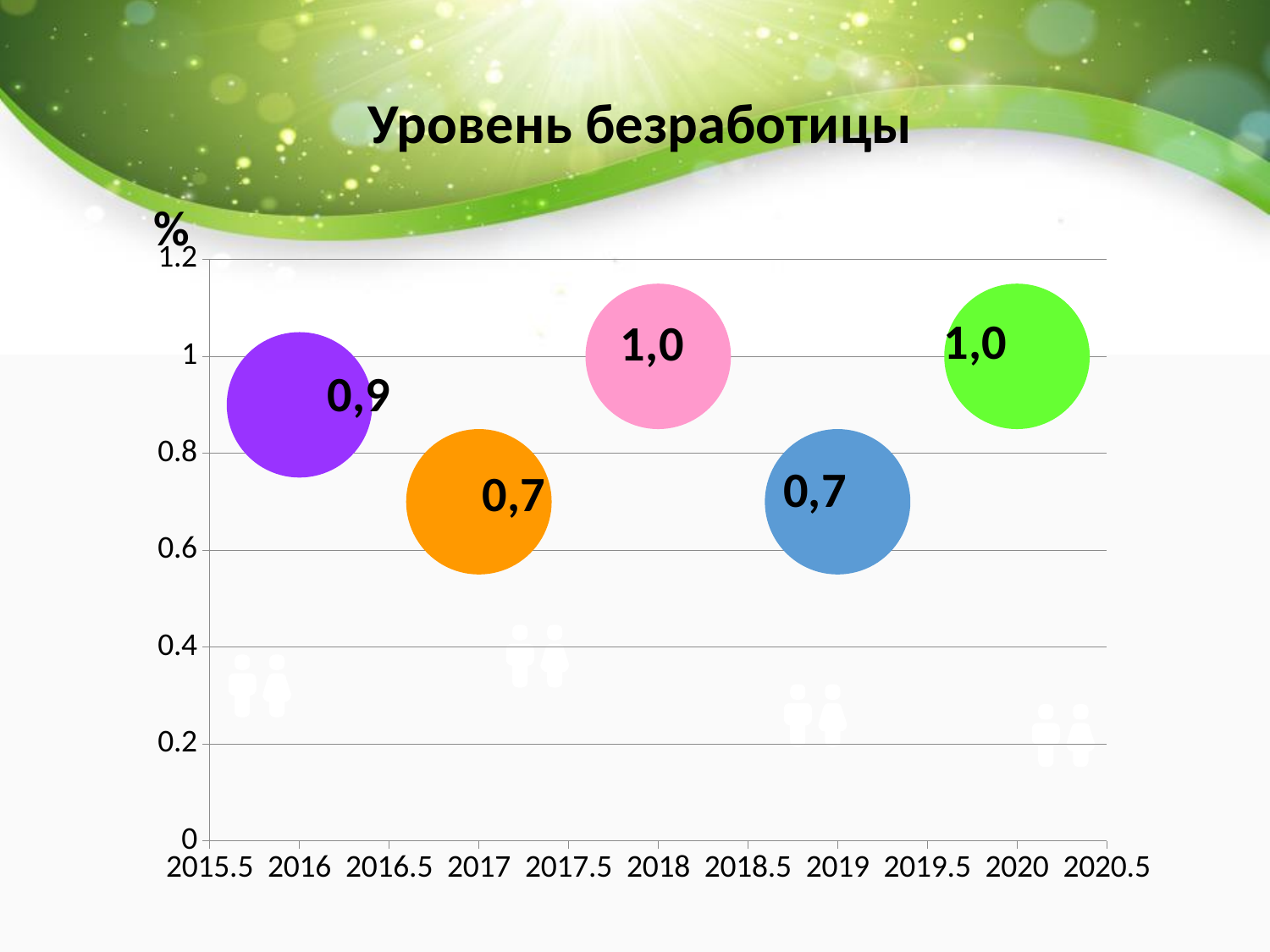
How many data points (years) are plotted on the chart? 5 What is the unemployment rate value shown for 2016? 0,9 What is the value shown for 2020? 1,0 What is the title of the chart? Уровень безработицы Which years have the highest value on the chart? 2018 and 2020 What is the value shown for 2017? 0,7 What is the value shown for 2018? 1,0 What kind of chart is shown on the slide? Bubble chart What is the value shown for 2019? 0,7 What is the difference between the values for 2016 and 2017? 0,2 Which year has the larger value, 2016 or 2017? 2016 Which years have the lowest value on the chart? 2017 and 2019